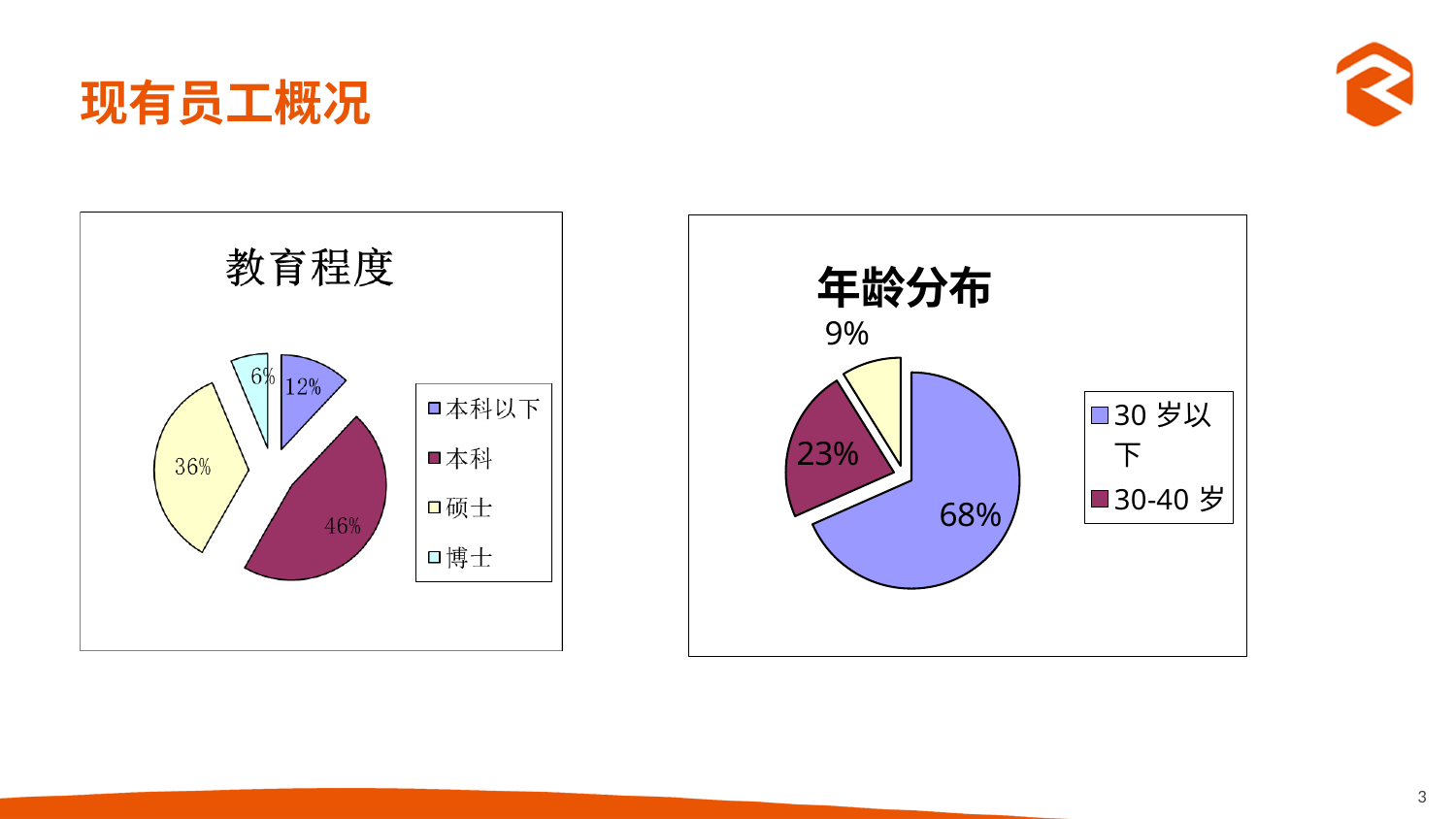
In the 教育程度 chart, what percentage is 博士? 6% In the 年龄分布 chart, what percentage is 30 岁以下? 68% In the 教育程度 chart, what percentage is 本科? 46% In the 教育程度 chart, which is larger, 本科以下 or 博士? 本科以下 How many slices does the 教育程度 pie chart have? 4 In the 教育程度 chart, what percentage is 硕士? 36% In the 年龄分布 chart, what percentage is 30-40 岁? 23% What type of chart is the 年龄分布 chart? pie chart In the 年龄分布 chart, what is the difference between the 30 岁以下 and 30-40 岁 shares? 45% In the 教育程度 chart, what is the difference between the 本科 and 硕士 shares? 10% In the 教育程度 chart, which category has the largest share? 本科 In the 教育程度 chart, which category has the smallest share? 博士